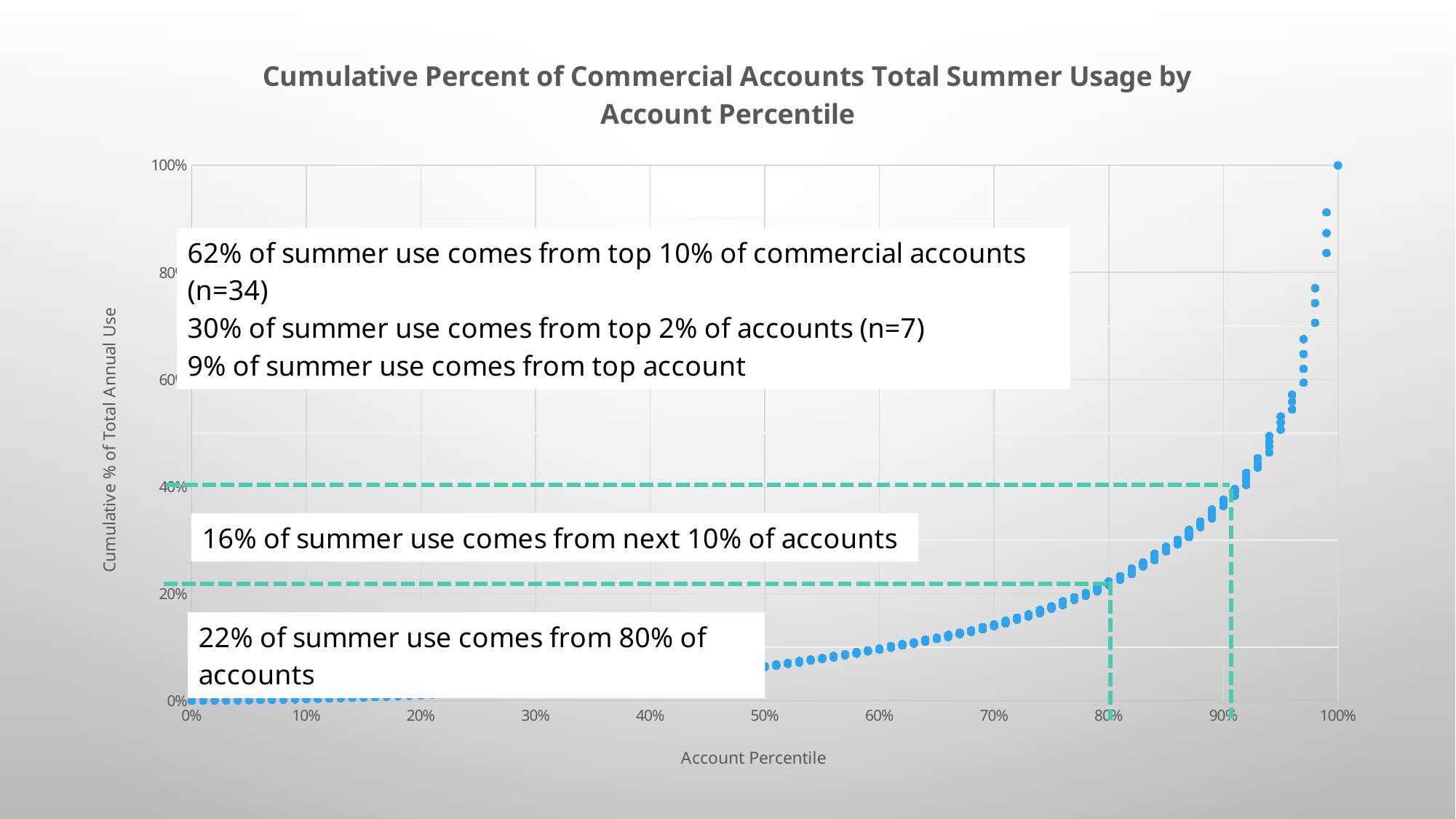
According to the annotation, what percent of summer use comes from 80% of accounts? 22% What is the label of the x axis? Account Percentile At which account percentile does the plotted cumulative % of total annual use reach its highest value? 100% According to the annotation, what percent of summer use comes from the top account? 9% What is the cumulative % of total annual use at the 100% account percentile? 100% According to the annotation, what percent of summer use comes from the top 10% of commercial accounts? 62% Do the plotted values rise or fall as the account percentile increases along the x axis? rise What kind of chart is shown on the slide? scatter chart Is the cumulative % of total annual use at the 50% account percentile greater or less than 20%? less Is the cumulative % of total annual use at the 95% account percentile greater or less than 40%? greater What is the title of the chart? Cumulative Percent of Commercial Accounts Total Summer Usage by Account Percentile Is the cumulative % of total annual use at the 70% account percentile greater or less than 20%? less